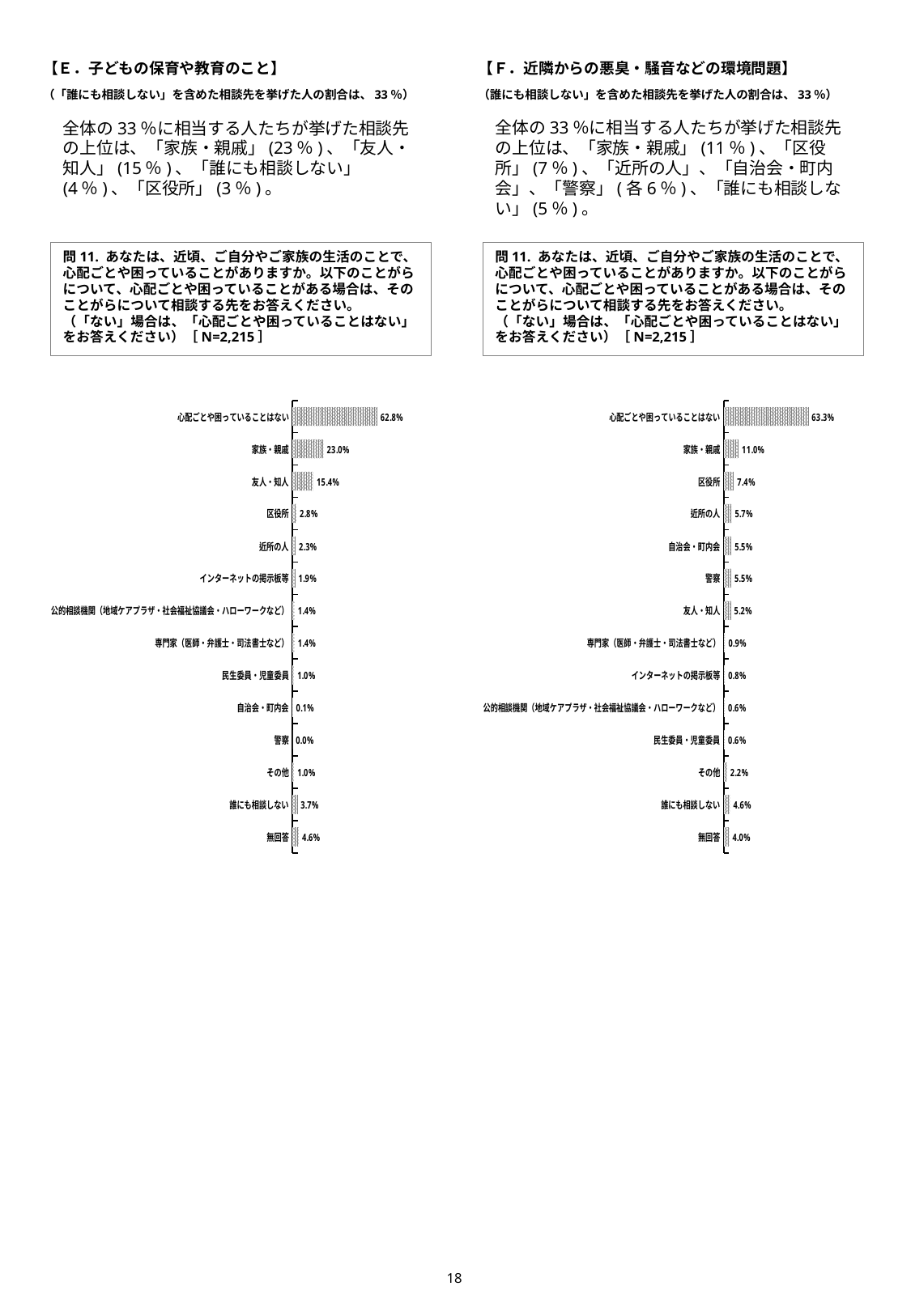
In the left chart (E. 子どもの保育や教育のこと), what is the difference between 家族・親戚 and 友人・知人? 7.6% In the right chart (F. 近隣からの悪臭・騒音などの環境問題), what is the value for 区役所? 7.4% In the right chart (F. 近隣からの悪臭・騒音などの環境問題), what is the value for 心配ごとや困っていることはない? 63.3% In the left chart (E. 子どもの保育や教育のこと), what is the value for 友人・知人? 15.4% In the right chart (F. 近隣からの悪臭・騒音などの環境問題), what is the difference between 家族・親戚 and 区役所? 3.6% In the right chart (F. 近隣からの悪臭・騒音などの環境問題), which is larger, 近所の人 or 友人・知人? 近所の人 In the left chart (E. 子どもの保育や教育のこと), which category has the lowest value? 警察 What kind of chart is the right chart (F. 近隣からの悪臭・騒音などの環境問題)? Bar chart In the left chart (E. 子どもの保育や教育のこと), which category has the highest value? 心配ごとや困っていることはない In the left chart (E. 子どもの保育や教育のこと), what is the value for 家族・親戚? 23.0% How many categories does the left chart (E. 子どもの保育や教育のこと) show? 14 In the right chart (F. 近隣からの悪臭・騒音などの環境問題), what is the value for 誰にも相談しない? 4.6%